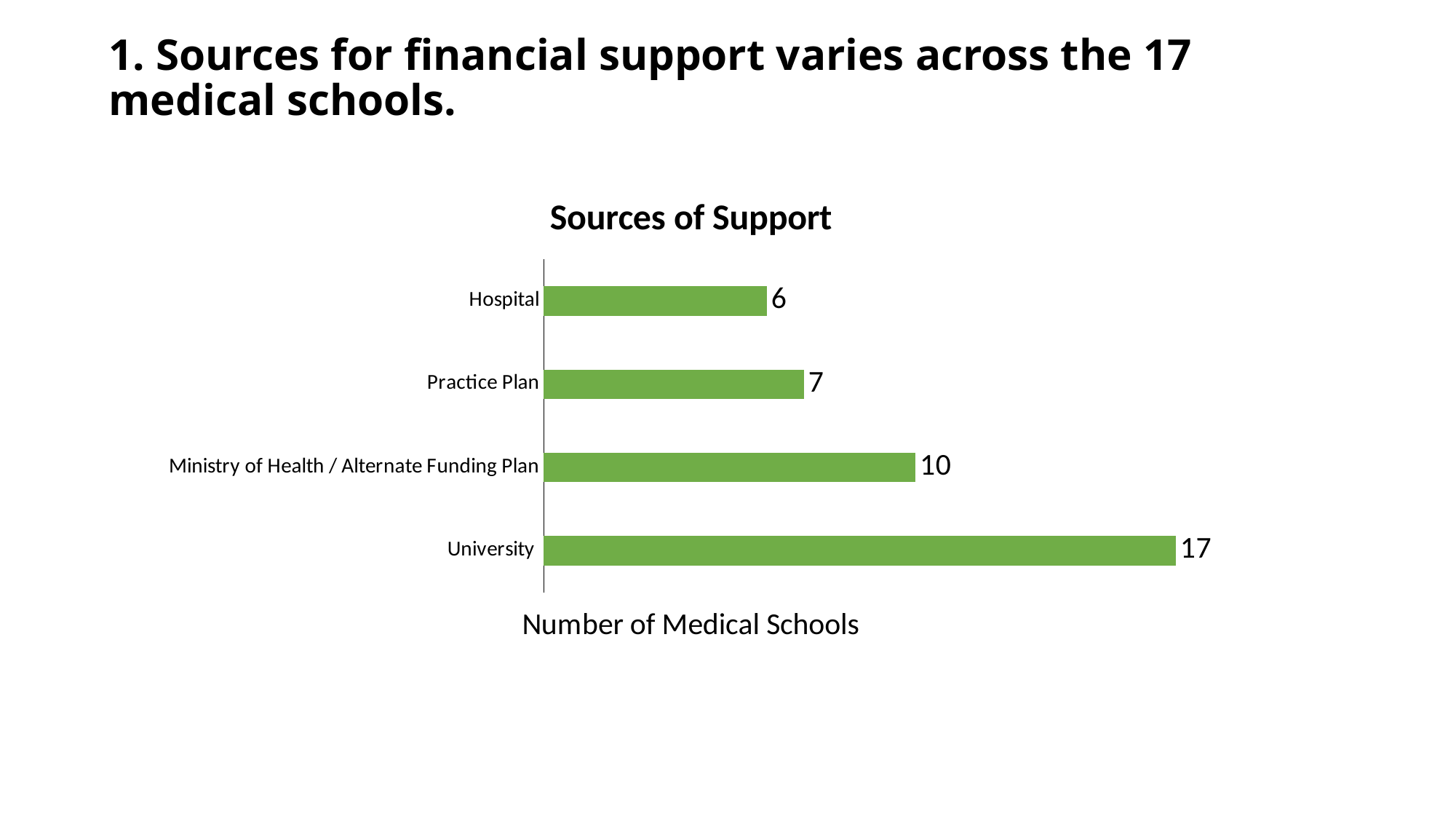
What is the value for Hospital? 6 What is the value for Practice Plan? 7 How many categories are shown in the chart? 4 Which source of support has the lowest number of medical schools? Hospital What is the title of the chart? Sources of Support Which is larger, the value for Ministry of Health / Alternate Funding Plan or the value for Practice Plan? Ministry of Health / Alternate Funding Plan What is the value for Ministry of Health / Alternate Funding Plan? 10 What kind of chart is shown on the slide? Bar chart Which source of support has the highest number of medical schools? University What is the value for University? 17 What is the difference between the values for Practice Plan and Hospital? 1 What is the difference between the values for University and Ministry of Health / Alternate Funding Plan? 7